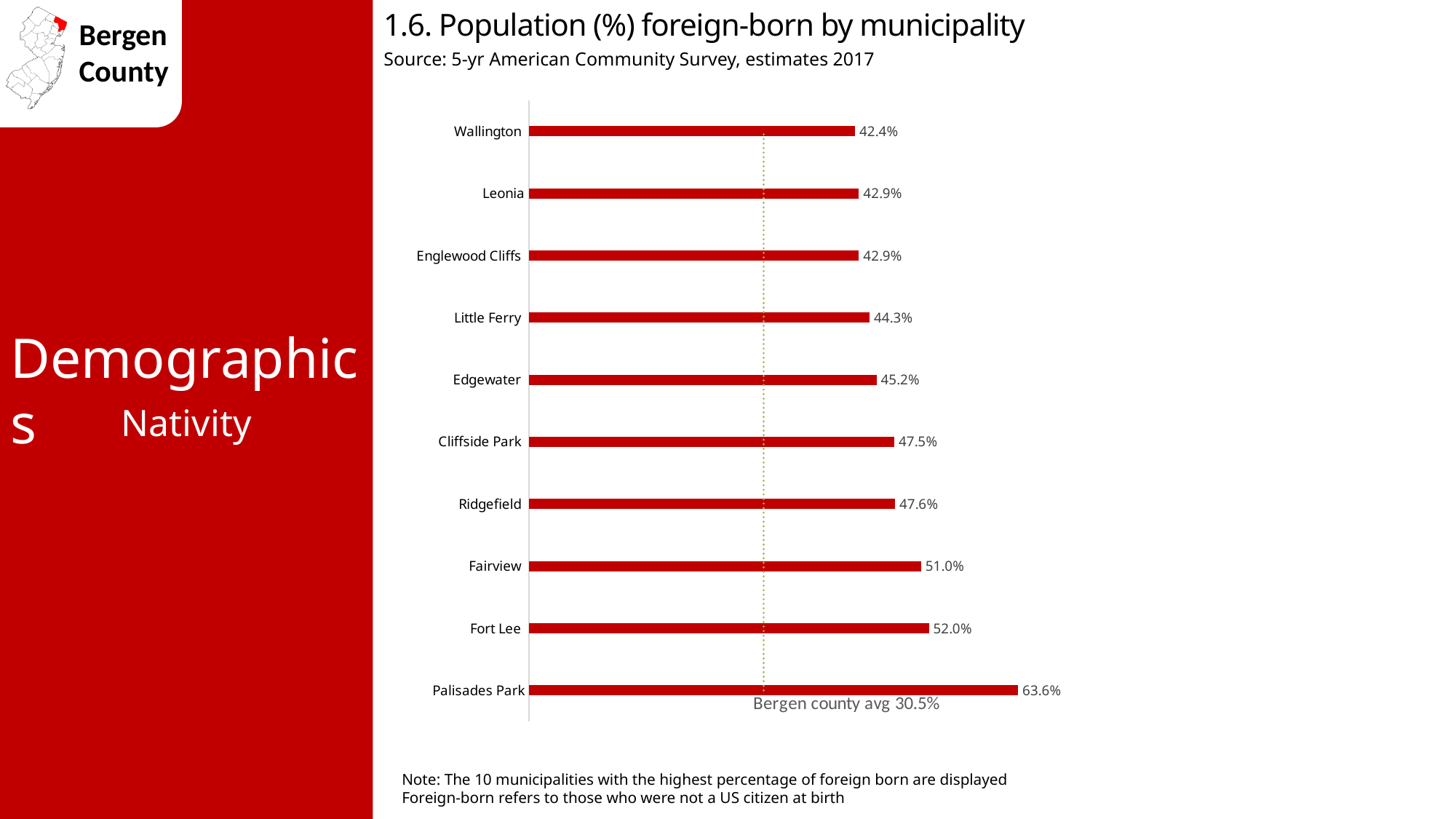
What is the difference between the foreign-born percentages of Fairview and Little Ferry? 6.7% Which municipality has the lowest foreign-born percentage shown? Wallington What is the foreign-born percentage for Edgewater? 45.2% Which municipality has the highest foreign-born percentage? Palisades Park What is the foreign-born percentage for Palisades Park? 63.6% How many municipalities are shown in the chart? 10 What is the title of the chart? 1.6. Population (%) foreign-born by municipality What is the Bergen county average foreign-born percentage marked on the chart? 30.5% Which has a higher foreign-born percentage, Fairview or Cliffside Park? Fairview What is the difference between the foreign-born percentages of Palisades Park and Fort Lee? 11.6% What is the foreign-born percentage for Fort Lee? 52.0% What kind of chart is shown on the slide? Bar chart